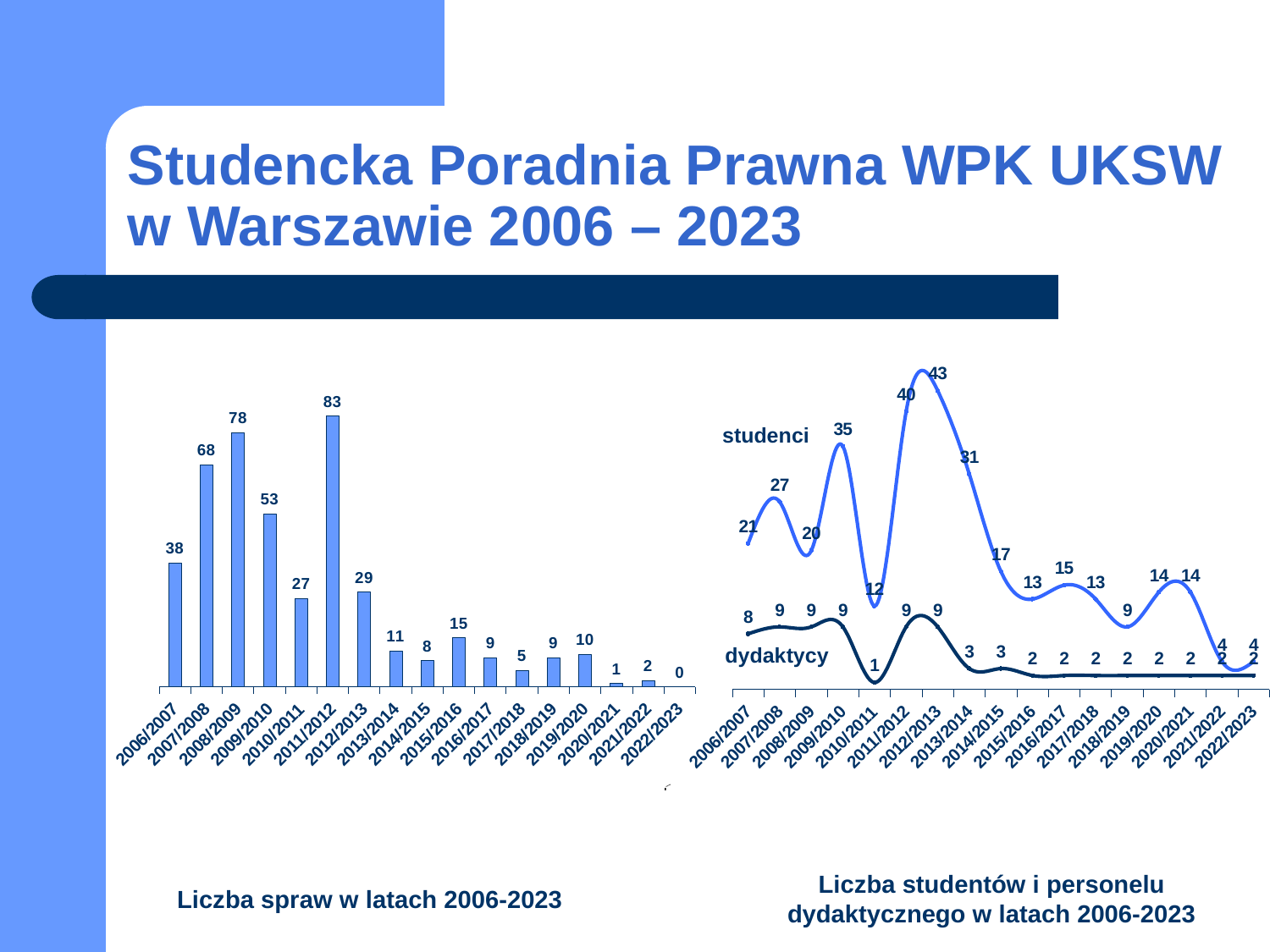
In the chart 'Liczba studentów i personelu dydaktycznego w latach 2006-2023', what is the value for studenci in 2012/2013? 43 What kind of chart is 'Liczba studentów i personelu dydaktycznego w latach 2006-2023'? line chart In the chart 'Liczba studentów i personelu dydaktycznego w latach 2006-2023', what is the value for dydaktycy in 2010/2011? 1 In the chart 'Liczba studentów i personelu dydaktycznego w latach 2006-2023', what is the difference between studenci and dydaktycy in 2011/2012? 31 In the chart 'Liczba spraw w latach 2006-2023', which year has the lowest value? 2022/2023 In the chart 'Liczba spraw w latach 2006-2023', which year has the highest value? 2011/2012 In the chart 'Liczba studentów i personelu dydaktycznego w latach 2006-2023', which is larger for 2009/2010: studenci or dydaktycy? studenci In the chart 'Liczba spraw w latach 2006-2023', what is the value for 2011/2012? 83 What kind of chart is 'Liczba spraw w latach 2006-2023'? bar chart In the chart 'Liczba spraw w latach 2006-2023', what is the difference between the values for 2008/2009 and 2009/2010? 25 In the chart 'Liczba spraw w latach 2006-2023', how many years are shown on the x axis? 17 In the chart 'Liczba studentów i personelu dydaktycznego w latach 2006-2023', which year has the highest value for studenci? 2012/2013